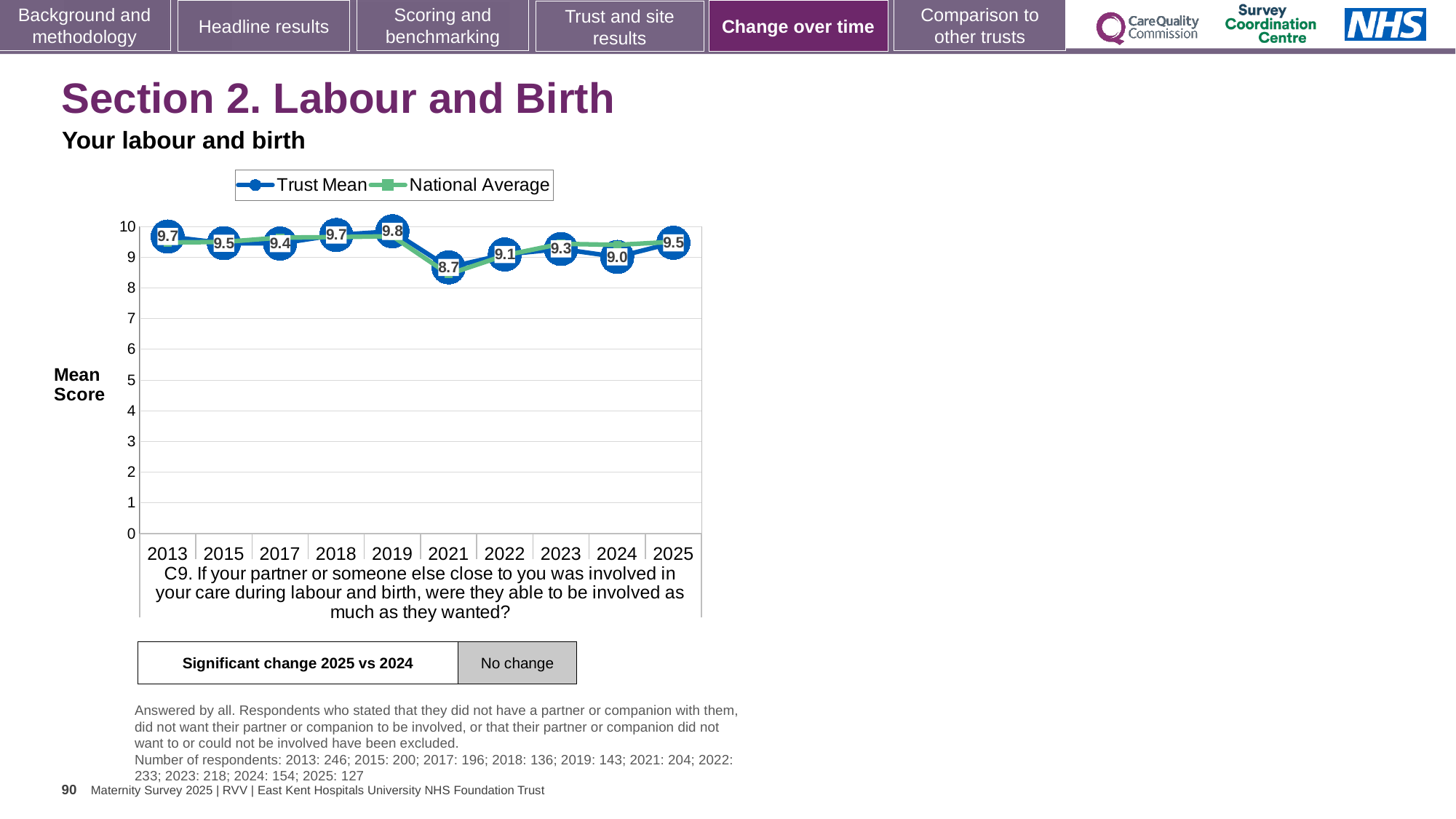
What is the difference between the Trust Mean in 2019 and in 2021? 1.1 Does the Trust Mean rise or fall from 2019 to 2021? Fall What is the Trust Mean value for 2025? 9.5 What kind of chart is shown on the slide? Line chart How many series does the legend list? 2 In which year is the Trust Mean highest? 2019 In which year is the Trust Mean lowest? 2021 How many years are shown on the x axis? 10 What is the Trust Mean value for 2021? 8.7 Is the National Average value for 2021 greater or less than 8? greater Which year has the larger Trust Mean, 2013 or 2024? 2013 What is the Trust Mean value for 2019? 9.8